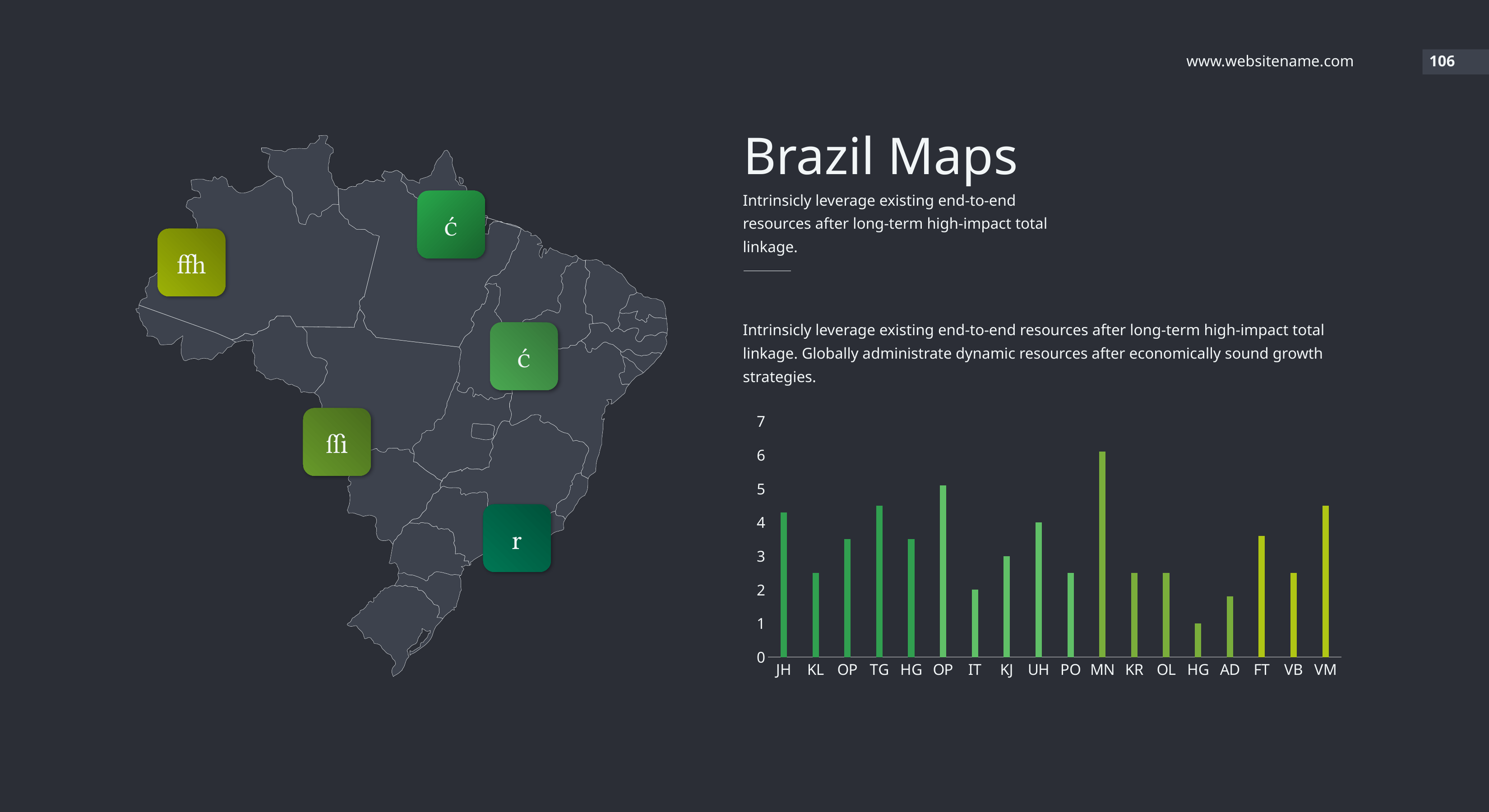
How many categories are shown on the x axis of the bar chart? 18 Is the value for IT greater or less than 3? less Which category has the lowest bar in the chart? HG Which is larger, the value for MN or the value for JH? MN Is the value for MN greater or less than 5? greater Is the value for KL greater or less than 3? less Which category has the highest bar in the chart? MN Which is larger, the value for IT or the value for TG? TG What is the highest value shown on the chart's vertical axis? 7 What kind of chart is shown on the slide? bar chart